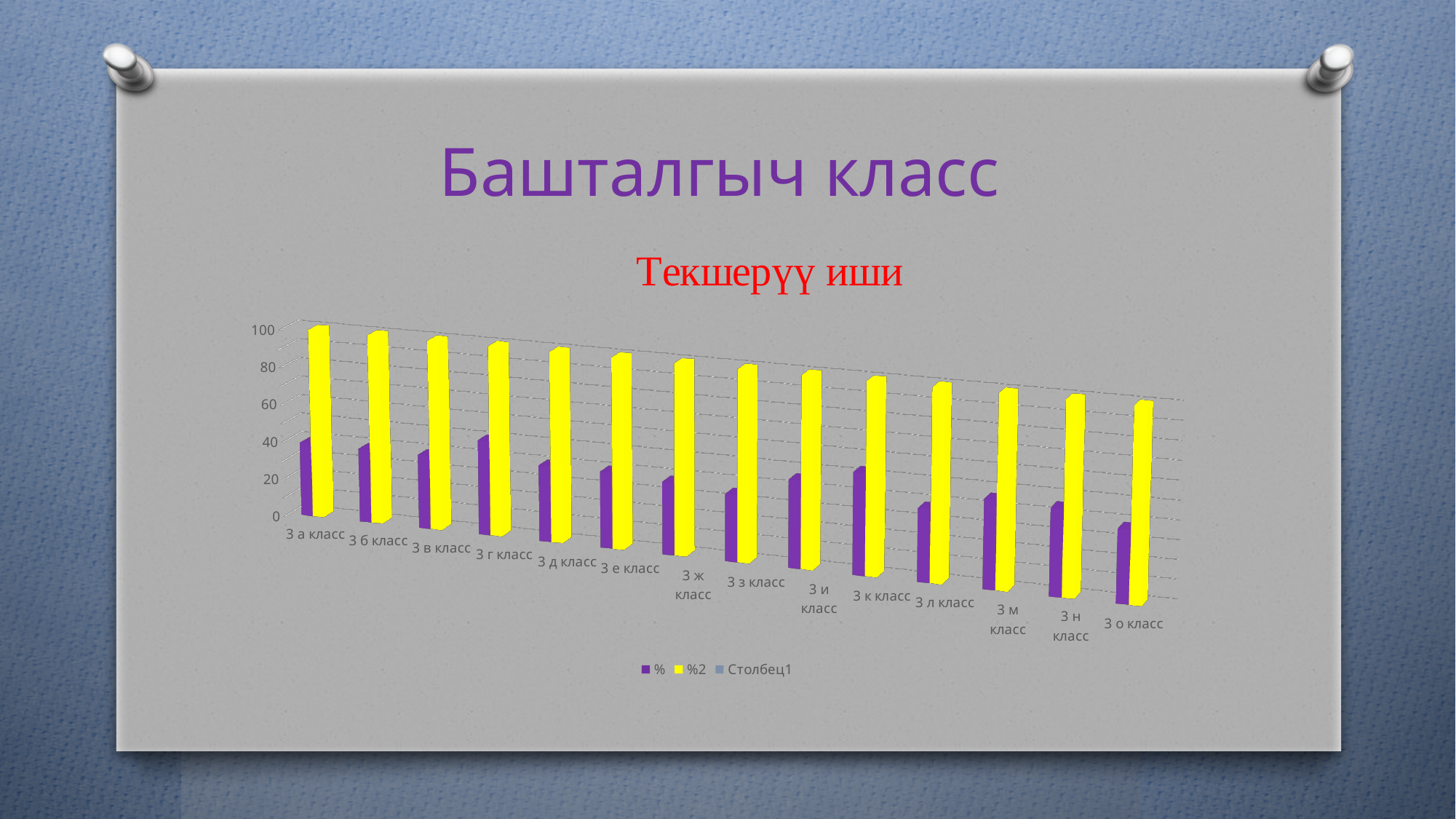
What is the title shown above the chart? Текшерүү иши Which category label appears first on the x axis? 3 а класс How many classes (categories) are shown on the x axis of the chart? 14 What are the series names listed in the chart legend? %, %2, Столбец1 Is the value of the % series for 3 а класс greater or less than 20? greater Is the value of the %2 series for 3 а класс greater or less than 80? greater How many series does the chart legend list? 3 For 3 о класс, which series has the larger value, % or %2? %2 What kind of chart is shown on the slide? bar chart For 3 а класс, which series has the larger value, % or %2? %2 Is the value of the % series for 3 а класс greater or less than 60? less